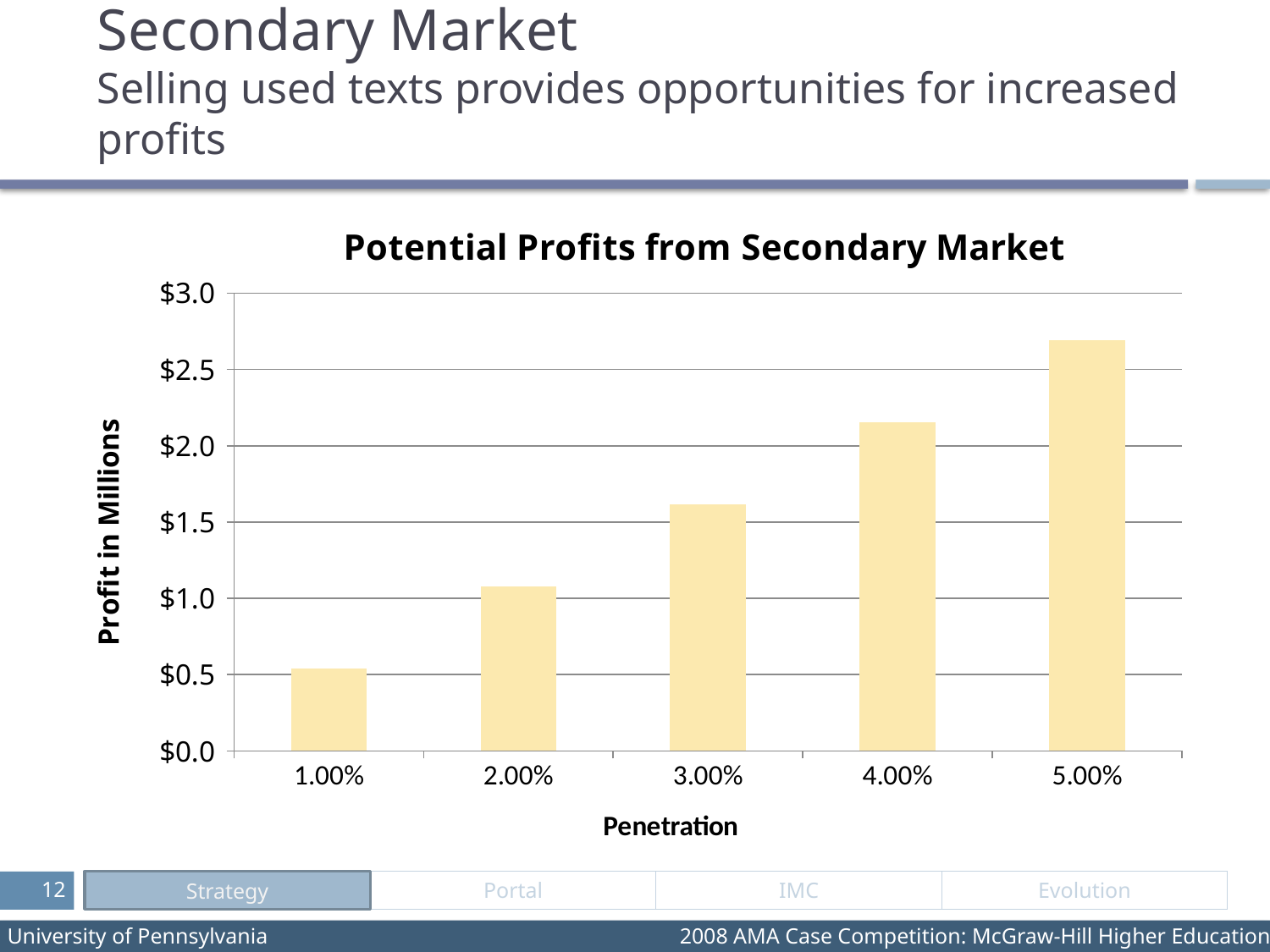
Which has a larger profit, 2.00% penetration or 4.00% penetration? 4.00% What is the title of the chart? Potential Profits from Secondary Market Is the profit at 3.00% penetration greater or less than $1.5 million? greater Is the profit at 5.00% penetration greater or less than $3.0 million? less Which penetration level has the highest profit? 5.00% What is the label of the vertical axis? Profit in Millions Do profits rise or fall as penetration increases along the x axis? rise How many penetration categories are plotted in the chart? 5 What kind of chart is shown on the slide? bar chart Which penetration level has the lowest profit? 1.00% Is the profit at 4.00% penetration greater or less than $2.0 million? greater